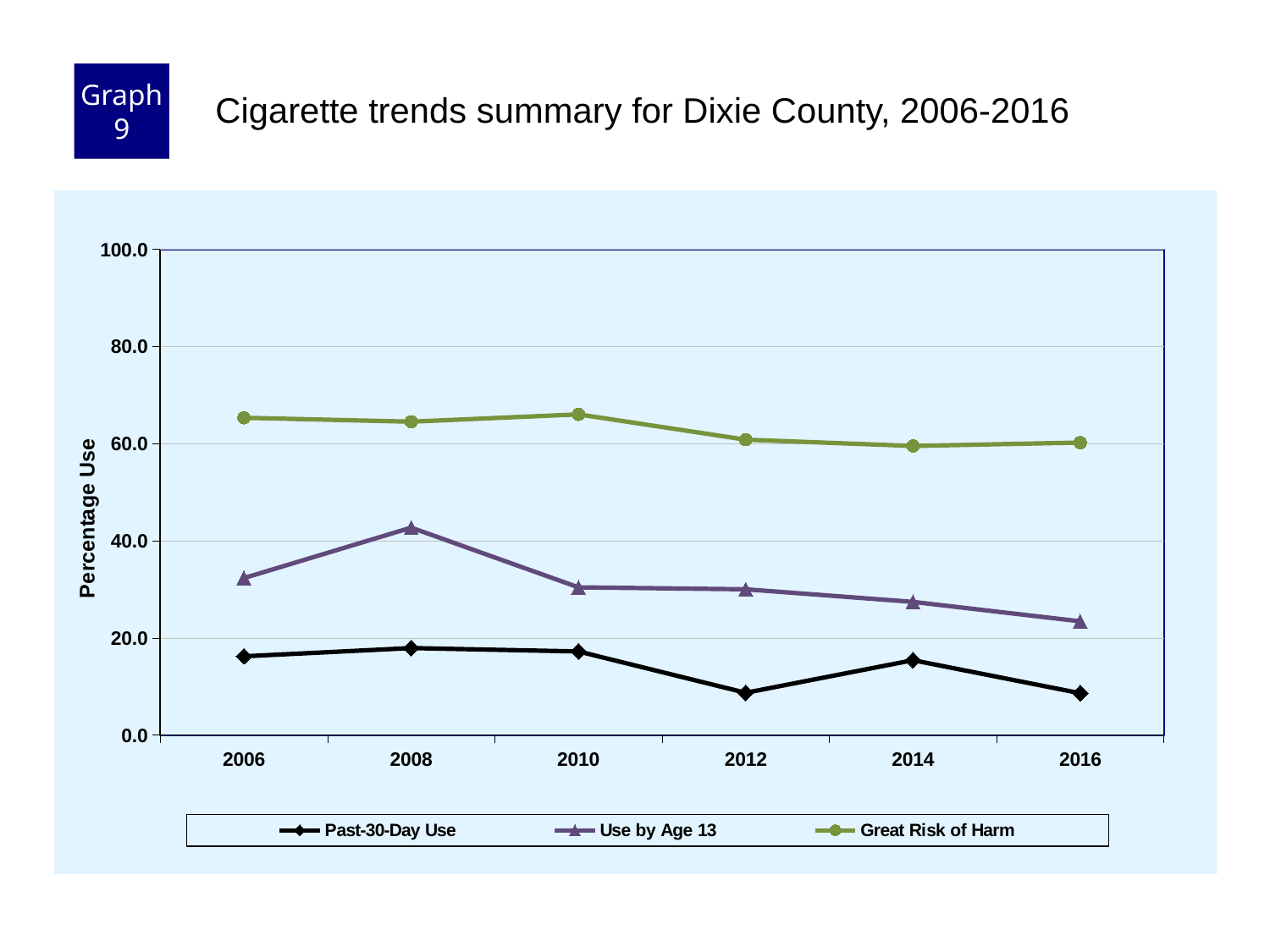
How many series does the legend list? 3 Which is larger for Use by Age 13: the value in 2008 or the value in 2016? 2008 Is the value for Use by Age 13 in 2016 greater or less than 20.0? greater Does the Use by Age 13 series rise or fall from 2008 to 2016? Fall Is the value for Past-30-Day Use in 2012 greater or less than 20.0? less What is the label on the vertical axis? Percentage Use How many years are plotted along the x axis? 6 What kind of chart is shown on the slide? Line chart Is the value for Great Risk of Harm in 2006 greater or less than 60.0? greater What is the title of the chart? Cigarette trends summary for Dixie County, 2006-2016 In which year is Use by Age 13 at its highest? 2008